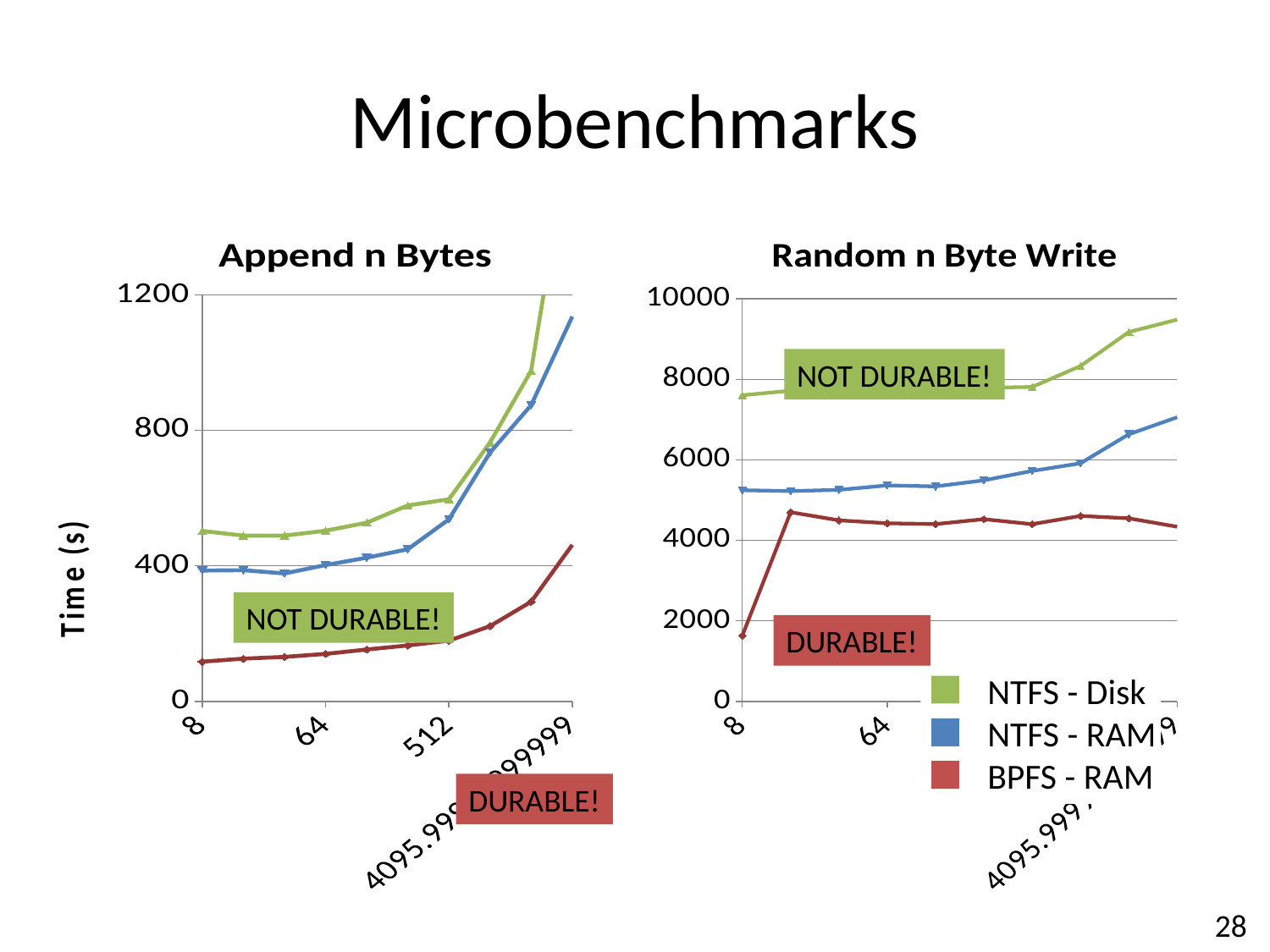
In the "Append n Bytes" chart, is the value for NTFS - Disk at 8 greater or less than 400? greater In the "Append n Bytes" chart, which is larger at 8: NTFS - Disk or BPFS - RAM? NTFS - Disk What is the y-axis label of the "Append n Bytes" chart? Time (s) In the "Random n Byte Write" chart, which is larger at 64: NTFS - Disk or NTFS - RAM? NTFS - Disk In the "Random n Byte Write" chart, is the value for NTFS - RAM at 8 greater or less than 6000? less In the "Append n Bytes" chart, do the values for BPFS - RAM rise or fall along the x axis? rise In the "Random n Byte Write" chart, is the value for BPFS - RAM at 8 greater or less than 2000? less What kind of chart is the "Append n Bytes" chart? line chart In the "Random n Byte Write" chart, which series has the highest values across the x axis? NTFS - Disk How many series does the legend list for the "Random n Byte Write" chart? 3